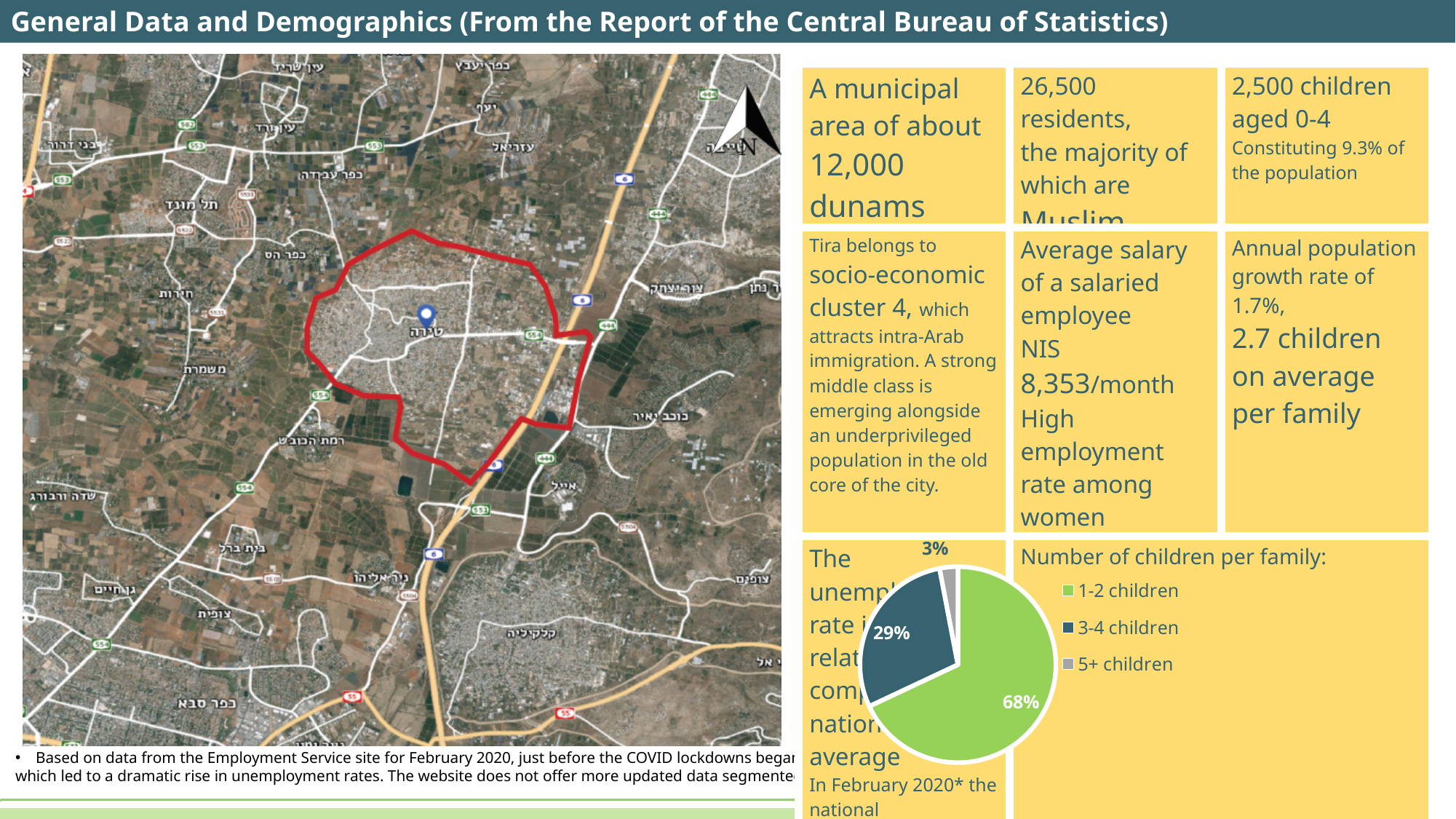
What kind of chart is shown under "Number of children per family"? pie chart What is the title of the pie chart on the slide? Number of children per family: Which category has the largest slice in the "Number of children per family" pie chart? 1-2 children In the "Number of children per family" pie chart, what share of families have 1-2 children? 68% How many categories does the legend of the "Number of children per family" pie chart list? 3 In the "Number of children per family" pie chart, what share of families have 5+ children? 3% In the "Number of children per family" pie chart, what share of families have 3-4 children? 29% In the "Number of children per family" pie chart, which is larger: the 3-4 children slice or the 5+ children slice? 3-4 children Which category has the smallest slice in the "Number of children per family" pie chart? 5+ children What colour is the 1-2 children slice in the "Number of children per family" pie chart? green In the "Number of children per family" pie chart, what is the combined share of families with 3-4 children and 5+ children? 32% In the "Number of children per family" pie chart, what is the difference in percentage points between the 1-2 children slice and the 3-4 children slice? 39